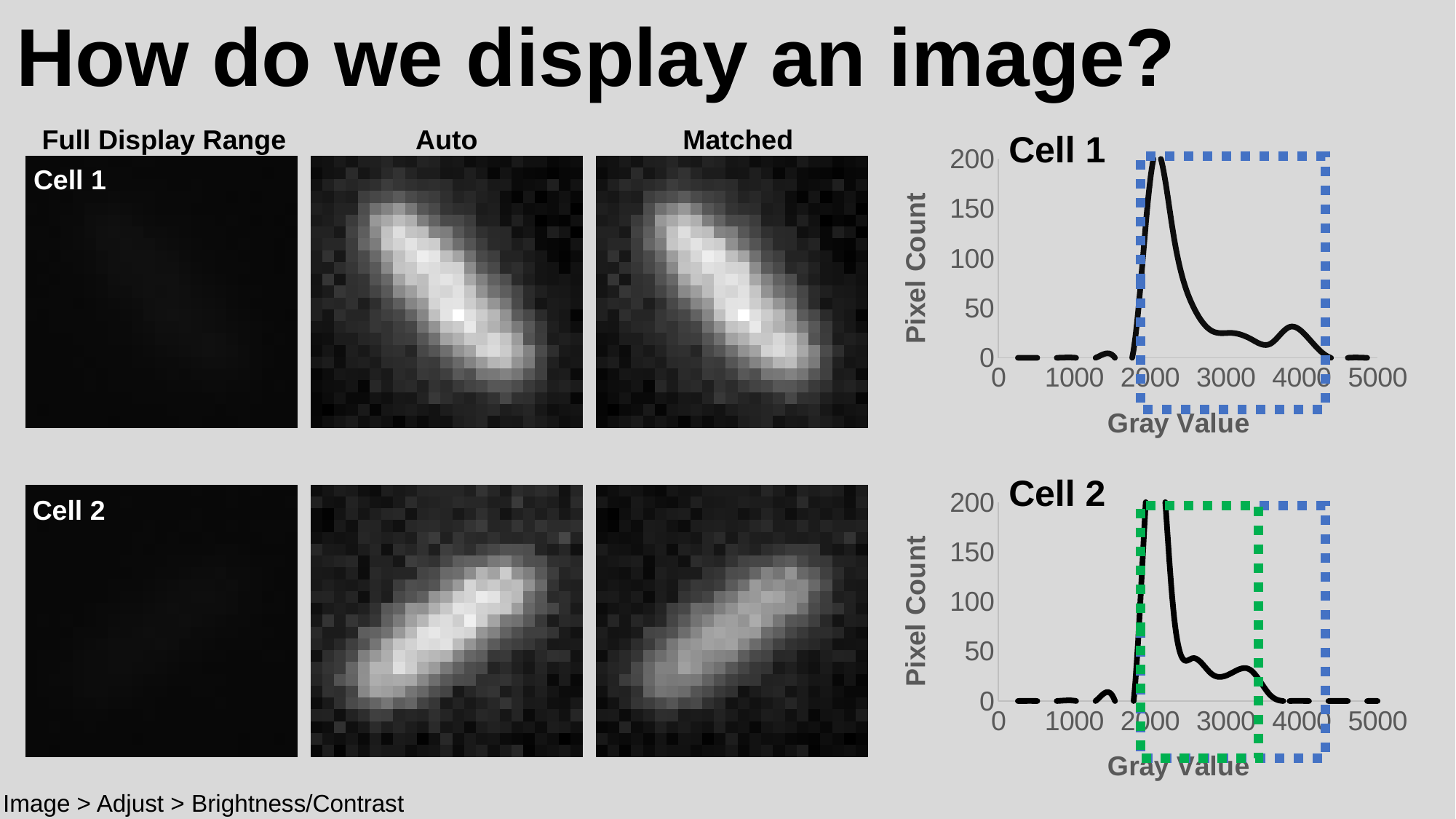
In the Cell 1 chart, is the peak pixel count greater or less than 150? greater What is the highest value labelled on the vertical axis of the Cell 1 chart? 200 What kind of chart is the Cell 1 chart? line chart In the Cell 2 chart, which has the larger pixel count: a gray value of 2500 or a gray value of 4000? 2500 In the Cell 1 chart, do the pixel counts rise or fall as the gray value goes from 2000 to 3000? fall In the Cell 1 chart, what is the pixel count at a gray value of 1000? 0 In the Cell 2 chart, is the pixel count at a gray value of 4000 greater or less than 50? less In the Cell 2 chart, is the peak pixel count greater or less than 100? greater How many tick labels are shown on the horizontal axis of the Cell 2 chart? 6 In the Cell 1 chart, what is the title of the horizontal axis? Gray Value In the Cell 2 chart, what is the title of the vertical axis? Pixel Count